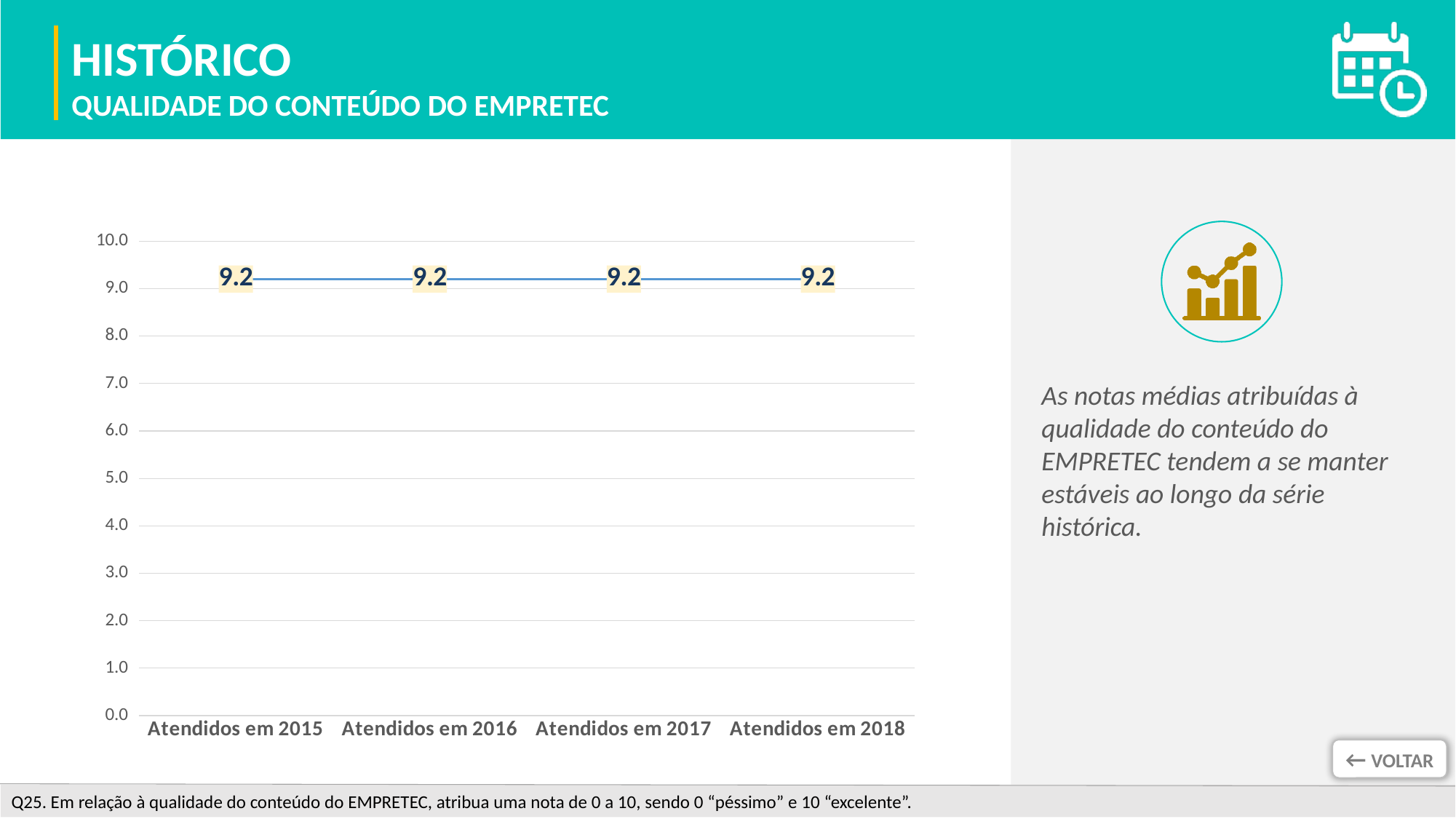
What is the value for Atendidos em 2015? 9.2 What is the difference between the values for Atendidos em 2018 and Atendidos em 2015? 0.0 What kind of chart is shown on the slide? Line chart What is the maximum value shown on the y axis? 10.0 What is the subtitle of the slide above the chart? QUALIDADE DO CONTEÚDO DO EMPRETEC How many categories are plotted on the x axis? 4 Is the value for Atendidos em 2016 greater or less than 10.0? less Do the values rise, fall or stay flat from Atendidos em 2015 to Atendidos em 2018? Stay flat Is the value for Atendidos em 2017 greater or less than 8.0? greater What is the value for Atendidos em 2017? 9.2 What is the value for Atendidos em 2018? 9.2 What is the value for Atendidos em 2016? 9.2